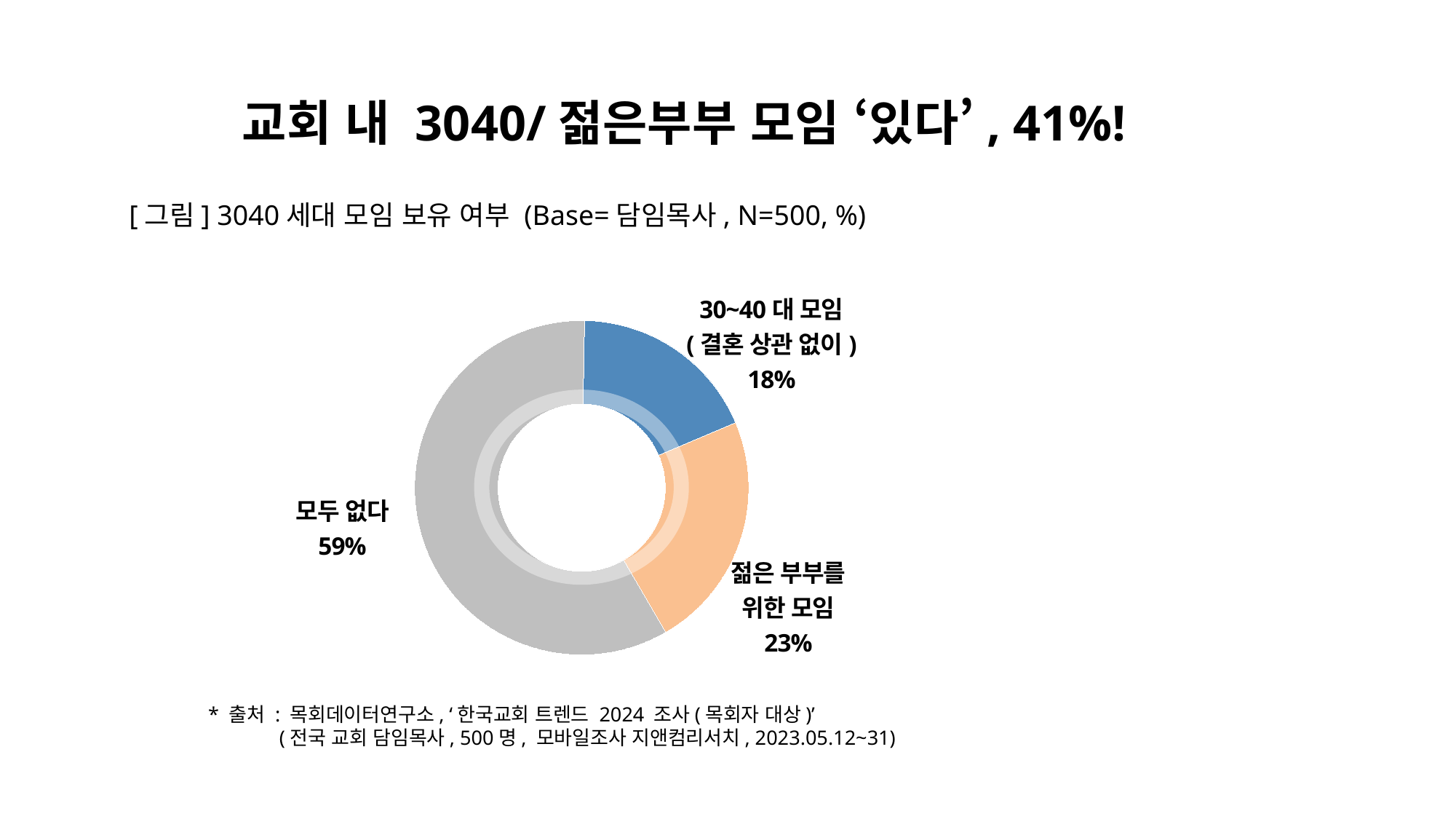
How many categories are shown in the chart? 3 What is the value for '모두 없다'? 59% What is the difference between '젊은 부부를 위한 모임' and '30~40대 모임 (결혼 상관 없이)'? 5% Which category has the smallest share of the chart? 30~40대 모임 (결혼 상관 없이) What is the difference between '모두 없다' and '젊은 부부를 위한 모임'? 36% What is the value for '30~40대 모임 (결혼 상관 없이)'? 18% Which category has the largest share of the chart? 모두 없다 Which is larger, '젊은 부부를 위한 모임' or '30~40대 모임 (결혼 상관 없이)'? 젊은 부부를 위한 모임 What kind of chart is shown on the slide? Donut (pie) chart What is the value for '젊은 부부를 위한 모임'? 23% What is the combined share of the two categories that have a meeting ('30~40대 모임' and '젊은 부부를 위한 모임')? 41% What colour is the '모두 없다' slice? Gray